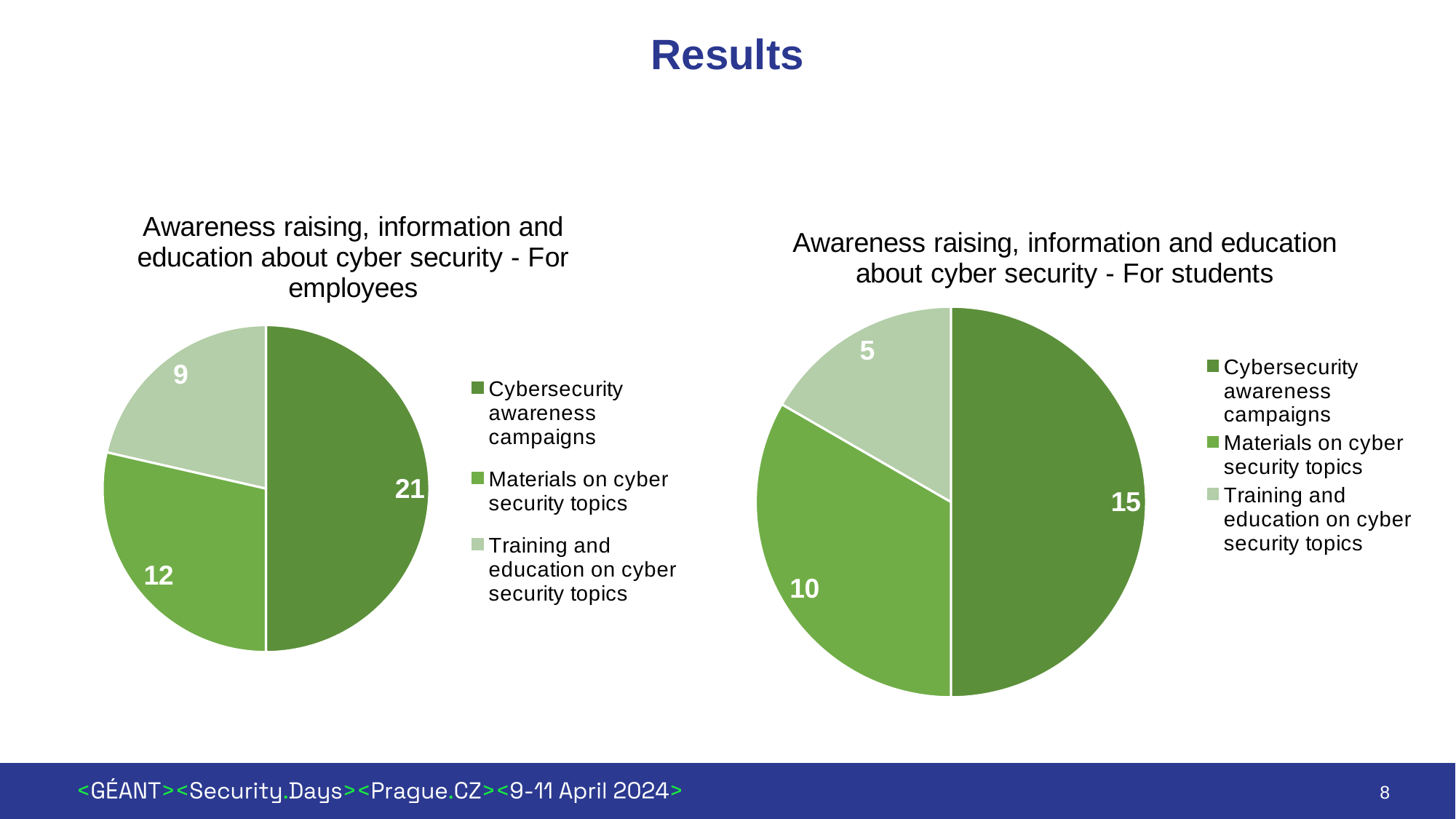
In the 'For employees' pie chart, what is the difference between Cybersecurity awareness campaigns and Materials on cyber security topics? 9 How many entries does the legend of the 'For employees' chart list? 3 How many slices does the 'For students' pie chart have? 3 In the 'For students' pie chart, what is the value for Training and education on cyber security topics? 5 In the 'For students' pie chart, what share of the total does Cybersecurity awareness campaigns represent? 50% In the 'For employees' pie chart, what is the value for Materials on cyber security topics? 12 What type of chart is used for the 'For employees' data? Pie chart In the 'For employees' pie chart, which category has the smallest slice? Training and education on cyber security topics Which is larger: Materials on cyber security topics in the 'For employees' chart or in the 'For students' chart? For employees In the 'For students' pie chart, what is the difference between Materials on cyber security topics and Training and education on cyber security topics? 5 In the 'For students' pie chart, which category has the largest slice? Cybersecurity awareness campaigns In the 'For employees' pie chart, what is the value for Cybersecurity awareness campaigns? 21